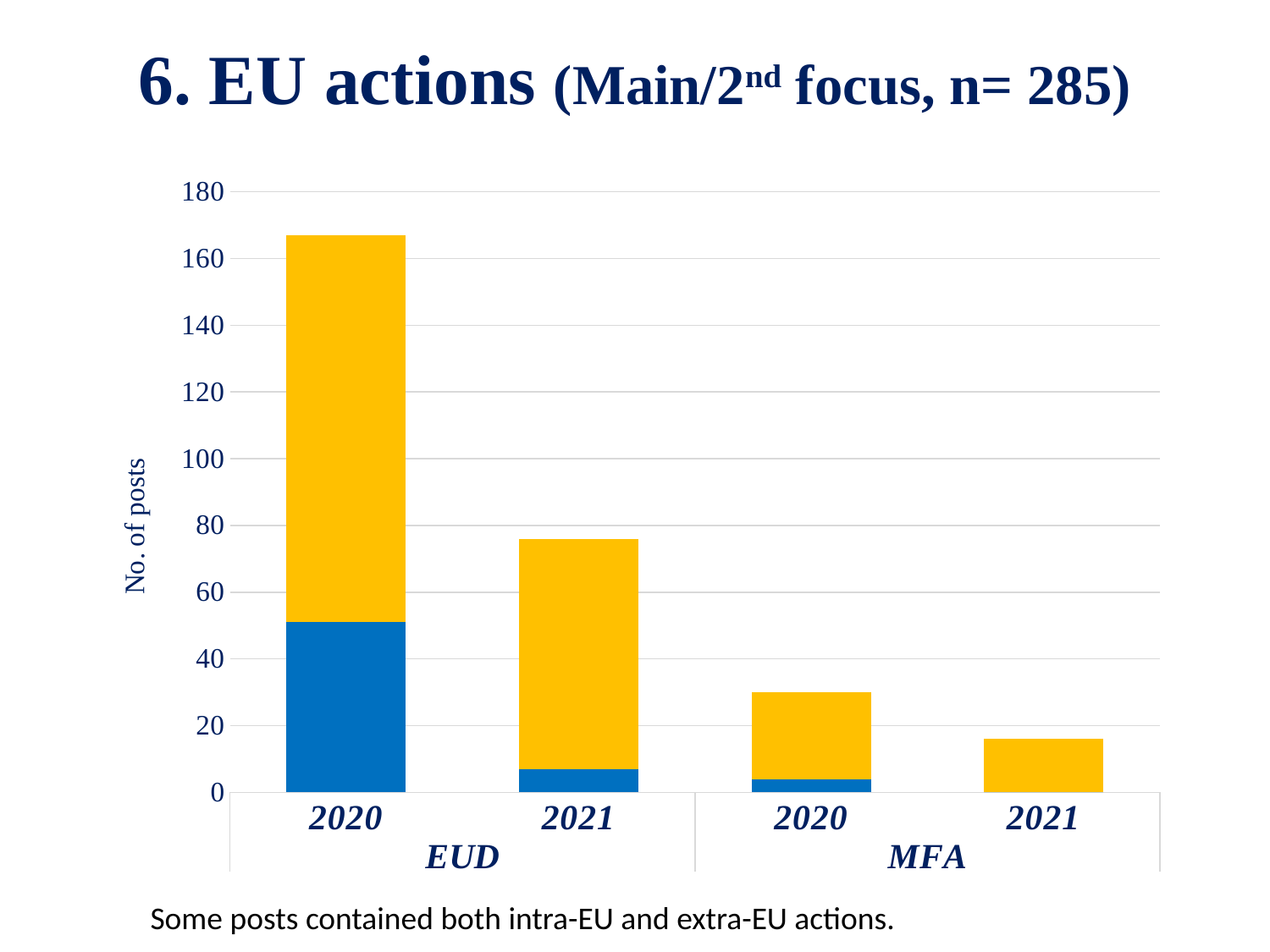
Is the total value for EUD 2021 greater or less than 60? greater How many bars are plotted in the chart? 4 Is the total value for MFA 2020 greater or less than 20? greater Which bar is the shortest in the chart? MFA 2021 Which bar is taller: EUD 2021 or MFA 2020? EUD 2021 What is the label on the vertical axis of the chart? No. of posts Which bar is the tallest in the chart? EUD 2020 Do the bar totals rise or fall from left to right across the chart? fall Is the blue segment for EUD 2020 greater or less than 40? greater What kind of chart is shown on the slide? Stacked bar chart